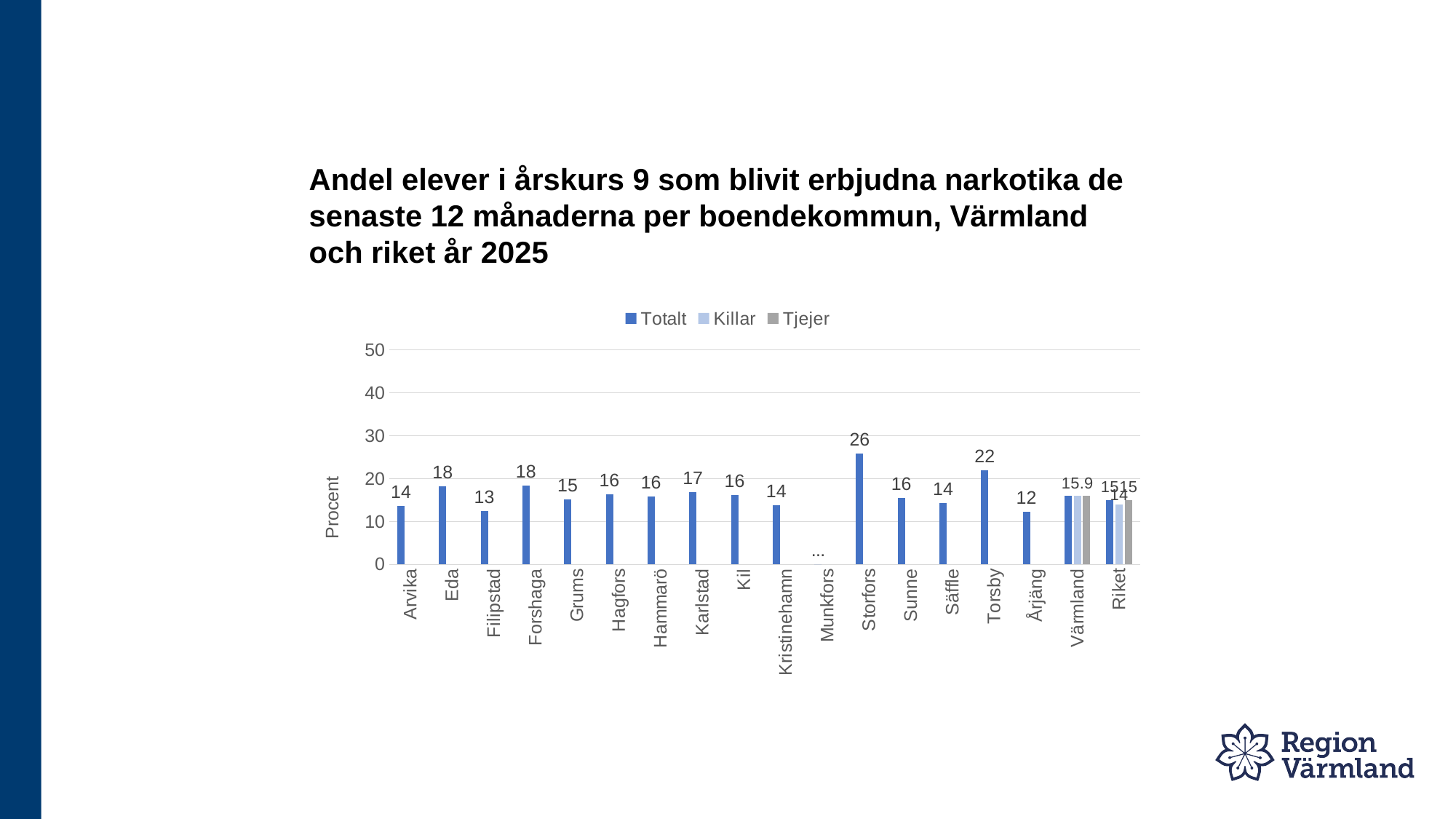
What kind of chart is shown on the slide? Bar chart Which municipality has the lowest plotted Totalt value? Årjäng Which has a higher Totalt value, Eda or Filipstad? Eda Which category has the highest Totalt value? Storfors What is the Totalt value for Torsby? 22 What is the Totalt value for Storfors? 26 How many series does the legend list? 3 What is the Totalt value for Värmland? 15.9 What is the label on the vertical axis? Procent Is the Totalt value for Torsby greater or less than 20? greater What is the difference between the Totalt values for Storfors and Årjäng? 14 What is the Totalt value for Filipstad? 13